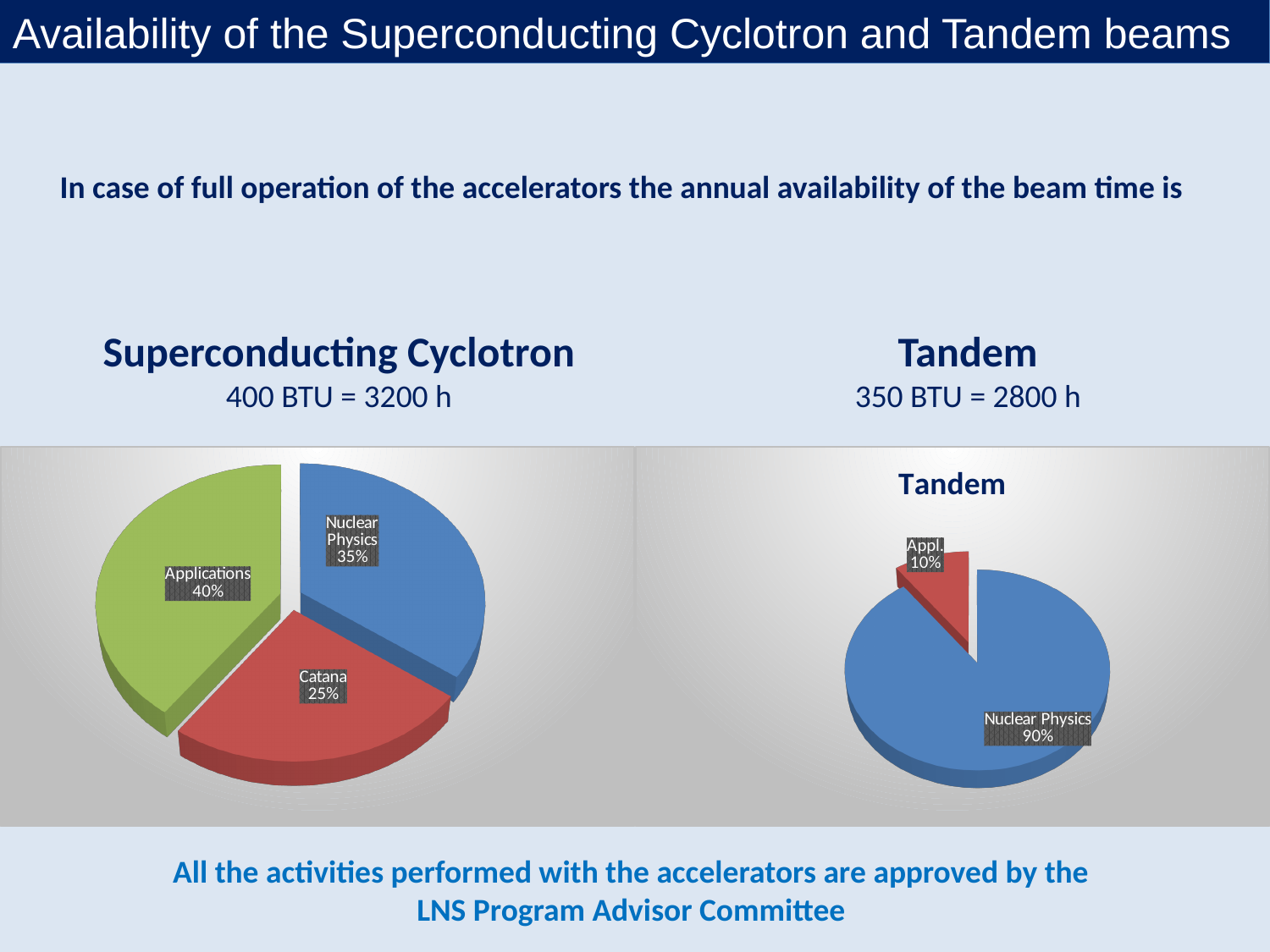
In the Tandem pie chart, what is the difference between the Nuclear Physics share and the Appl. share? 80% In the Superconducting Cyclotron pie chart, which is larger: Nuclear Physics or Catana? Nuclear Physics In the Superconducting Cyclotron pie chart, which category has the smallest share? Catana In the Tandem pie chart, what share does Nuclear Physics have? 90% In the Tandem pie chart, what share does Appl. have? 10% In the Superconducting Cyclotron pie chart, what share does Catana have? 25% In the Superconducting Cyclotron pie chart, what share does Nuclear Physics have? 35% In the Superconducting Cyclotron pie chart, which category has the largest share? Applications In the Superconducting Cyclotron pie chart, what share does Applications have? 40% What type of chart is the Tandem chart? Pie chart How many slices does the Superconducting Cyclotron pie chart have? 3 In the Superconducting Cyclotron pie chart, what is the difference between the Applications share and the Catana share? 15%